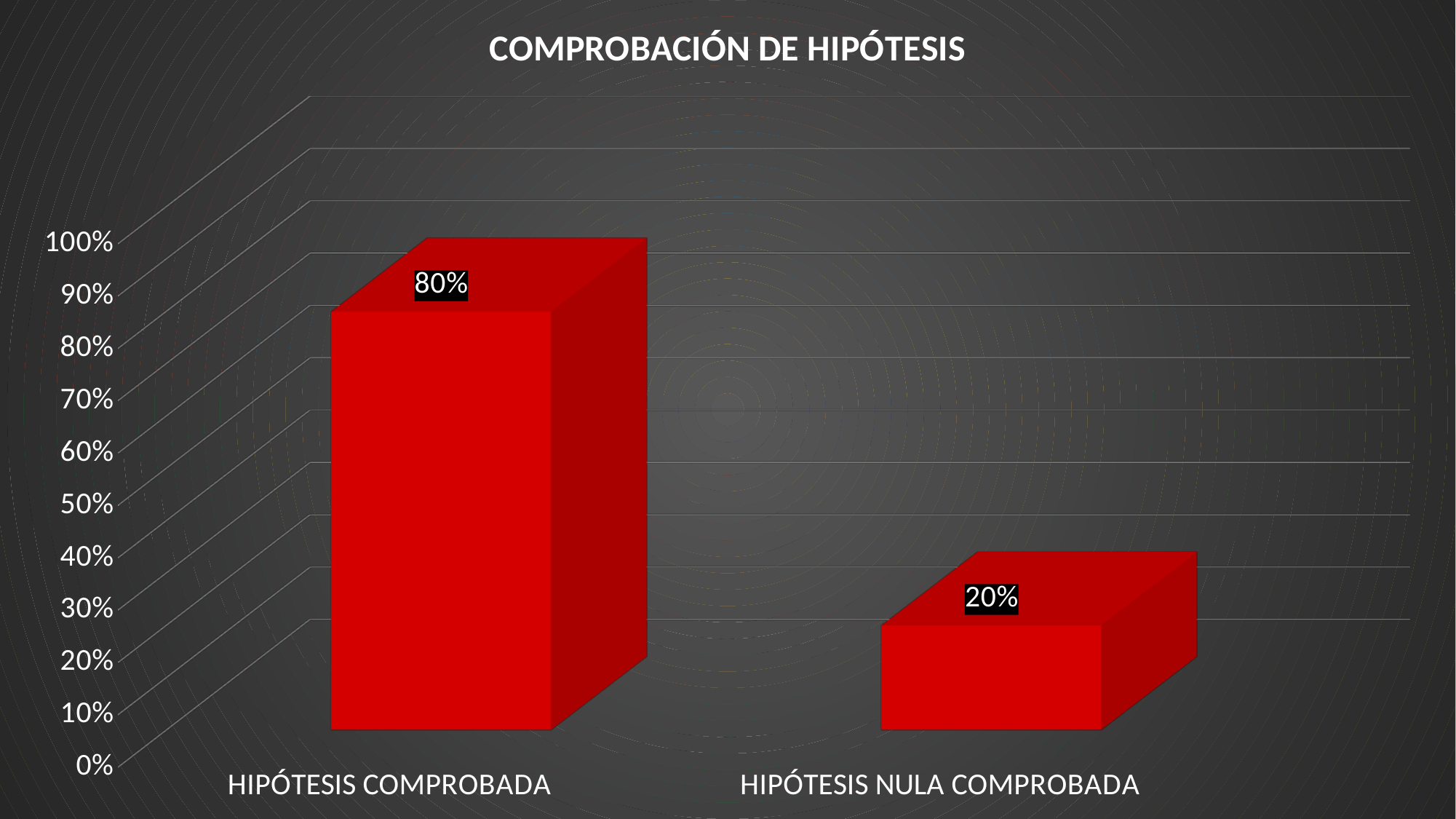
What colour are the bars in the chart? red Is the value for HIPÓTESIS COMPROBADA greater or less than 50%? greater What kind of chart is shown on the slide? bar chart Which category has the lowest value? HIPÓTESIS NULA COMPROBADA Which category has the highest value? HIPÓTESIS COMPROBADA What is the difference between the values for HIPÓTESIS COMPROBADA and HIPÓTESIS NULA COMPROBADA? 60% How many categories are shown on the chart? 2 Is the value for HIPÓTESIS NULA COMPROBADA greater or less than 50%? less Which is larger, the value for HIPÓTESIS COMPROBADA or the value for HIPÓTESIS NULA COMPROBADA? HIPÓTESIS COMPROBADA What is the value for HIPÓTESIS NULA COMPROBADA? 20% What is the title of the chart? COMPROBACIÓN DE HIPÓTESIS What is the value for HIPÓTESIS COMPROBADA? 80%